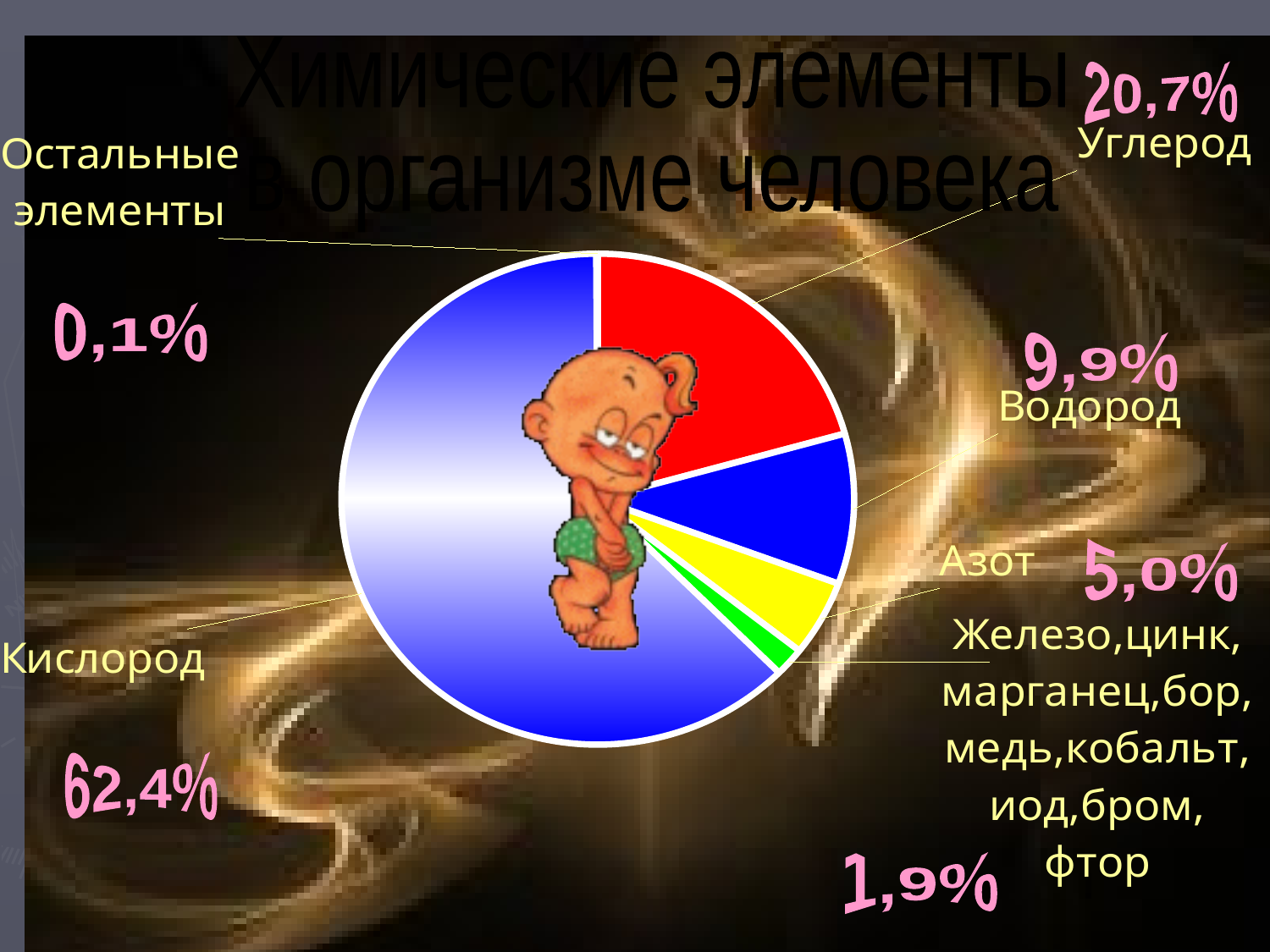
What percentage is shown for Углерод? 20,7% What percentage is shown for Водород? 9,9% How many slices does the pie chart have? 6 What is the title of the chart? Химические элементы в организме человека What percentage is shown for Кислород? 62,4% What is the difference between the shares of Кислород and Углерод? 41,7% Which is larger, the share of Водород or the share of Азот? Водород What kind of chart is shown on the slide? pie chart Which element has the largest share of the pie? Кислород Which category has the smallest share of the pie? Остальные элементы What percentage is shown for Остальные элементы? 0,1% What percentage is shown for Азот? 5,0%